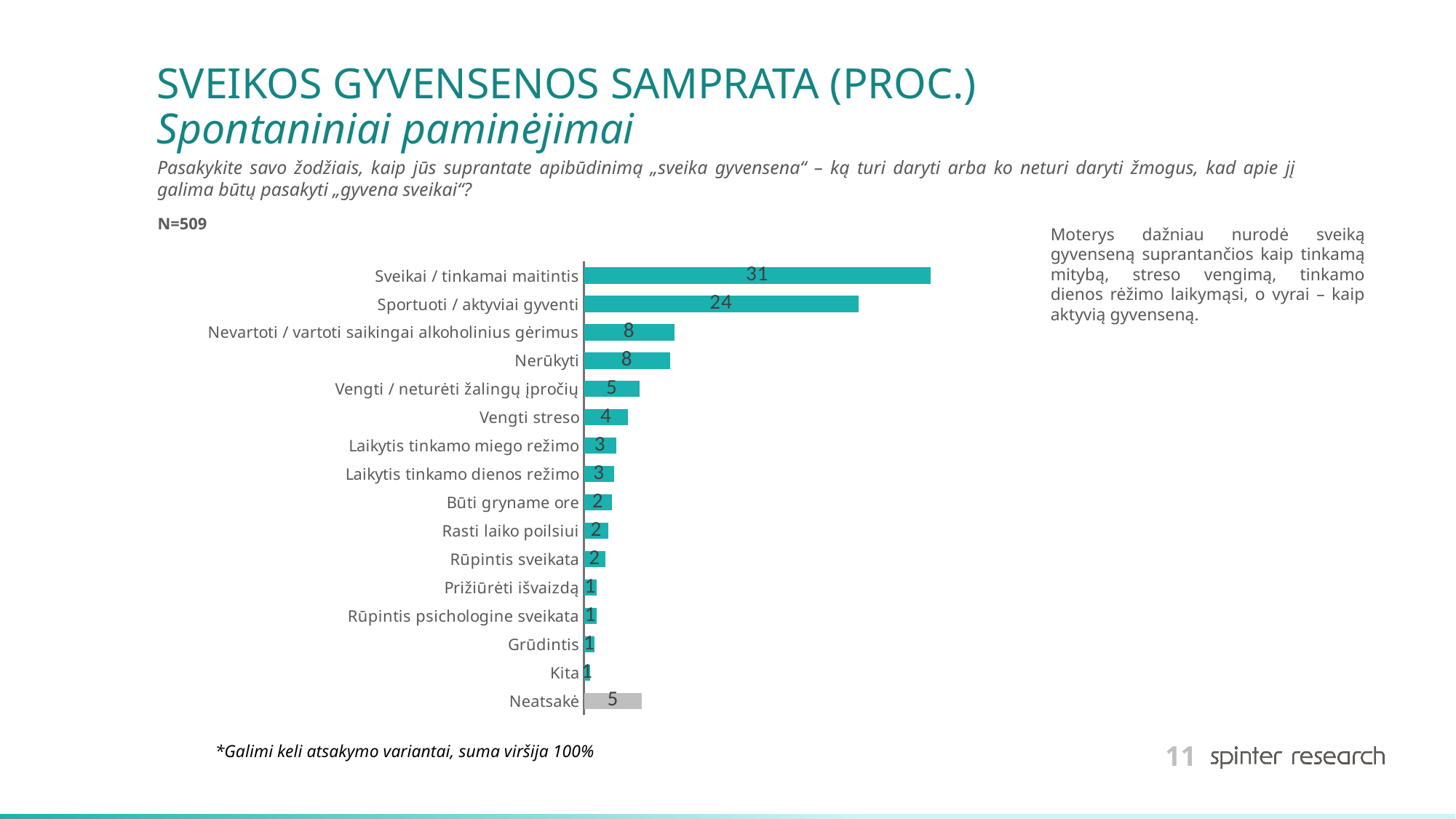
What value is shown for "Sportuoti / aktyviai gyventi"? 24 How many categories are plotted in the chart? 16 What kind of chart is shown on the slide? Bar chart Which is larger, the value for "Vengti streso" or the value for "Vengti / neturėti žalingų įpročių"? Vengti / neturėti žalingų įpročių What is the difference between the values for "Sveikai / tinkamai maitintis" and "Sportuoti / aktyviai gyventi"? 7 Which category has the highest value? Sveikai / tinkamai maitintis What value is shown for "Neatsakė"? 5 Which bar is shown in a different colour (grey) from the others? Neatsakė What is the sample size (N) stated on the slide? N=509 What value is shown for "Nerūkyti"? 8 What value is shown for "Sveikai / tinkamai maitintis"? 31 What value is shown for "Vengti streso"? 4